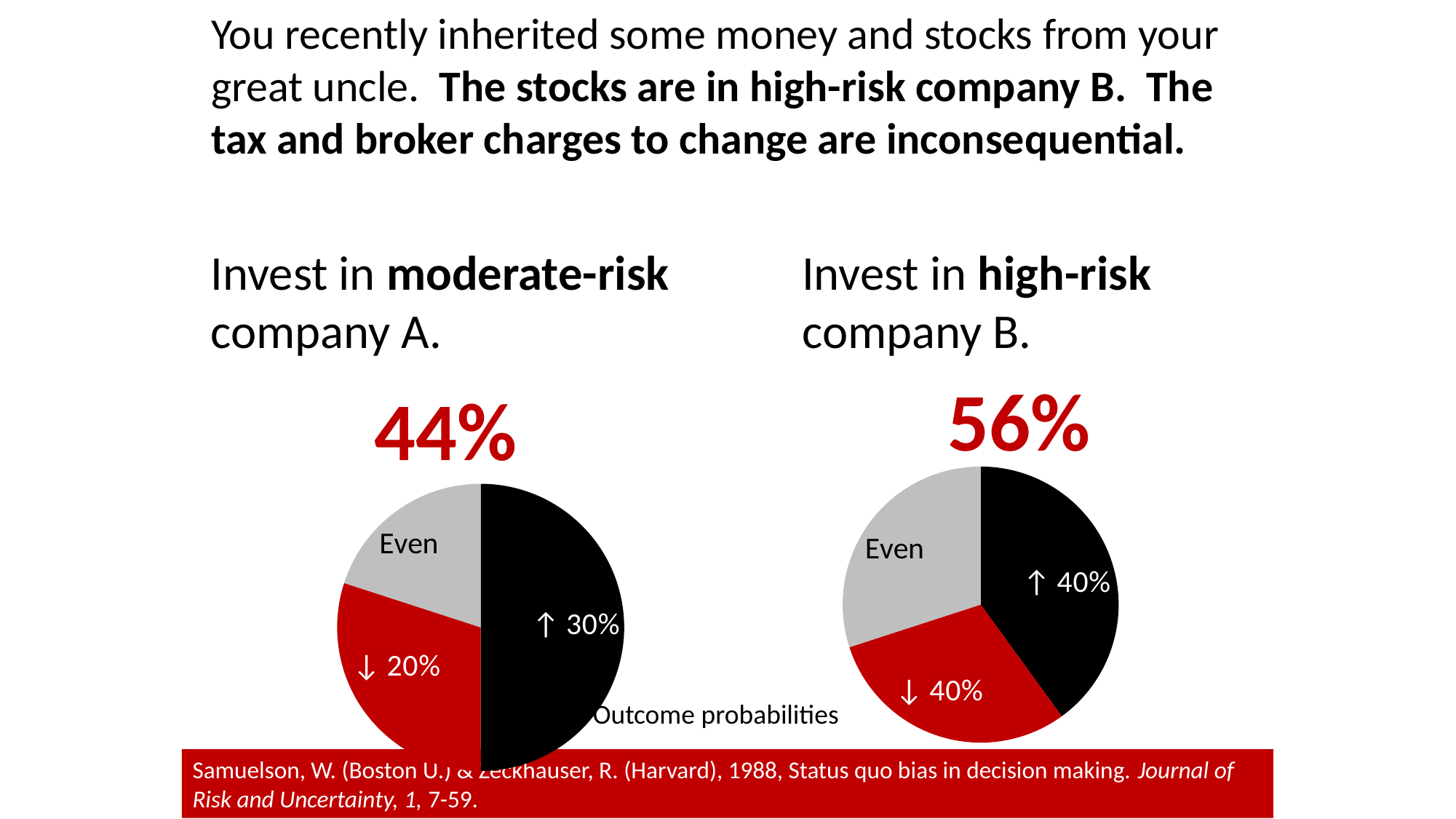
What colour is the 'Even' slice in both pie charts? Grey In the pie chart for moderate-risk company A, which slice is the smallest? Even How many slices does the pie chart for high-risk company B have? 3 What percentage is printed in red above the pie chart for high-risk company B? 56% In the pie chart for moderate-risk company A, which is larger, the ↑ slice or the ↓ slice? ↑ (30%) In the pie chart for moderate-risk company A, which slice is the largest? ↑ (30%) What kind of chart is used to show the outcome probabilities for company A and company B? Pie chart